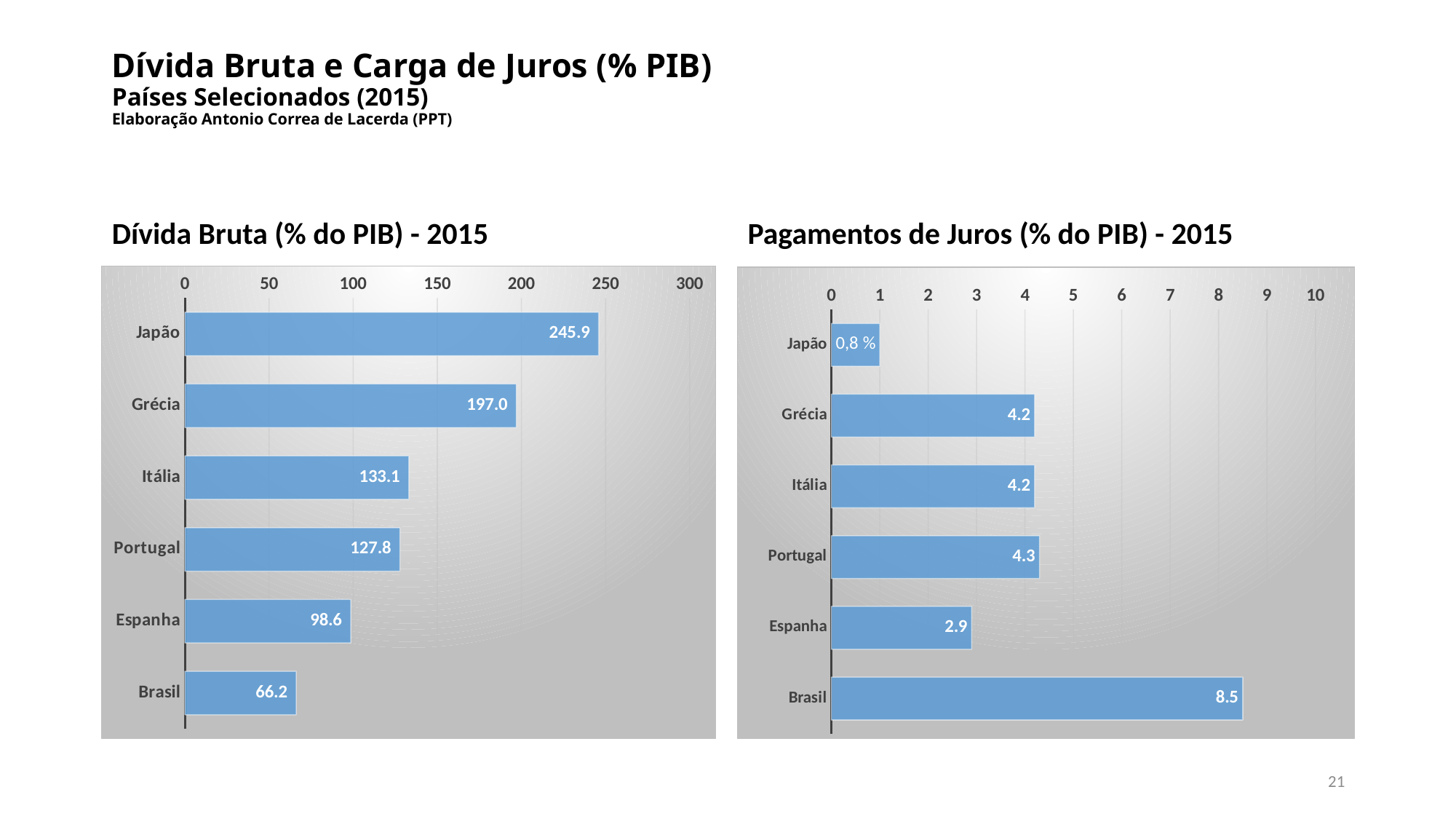
In the 'Dívida Bruta (% do PIB) - 2015' chart, what is the value for Japão? 245.9 What kind of chart is the 'Dívida Bruta (% do PIB) - 2015' chart? Bar chart In the 'Pagamentos de Juros (% do PIB) - 2015' chart, which country has the lowest value? Japão In the 'Dívida Bruta (% do PIB) - 2015' chart, how many countries are shown? 6 In the 'Dívida Bruta (% do PIB) - 2015' chart, what is the difference between the values for Grécia and Itália? 63.9 In the 'Pagamentos de Juros (% do PIB) - 2015' chart, what is the value for Espanha? 2.9 In the 'Pagamentos de Juros (% do PIB) - 2015' chart, what is the value for Brasil? 8.5 In the 'Dívida Bruta (% do PIB) - 2015' chart, what is the value for Brasil? 66.2 In the 'Pagamentos de Juros (% do PIB) - 2015' chart, which is larger, the value for Portugal or the value for Espanha? Portugal In the 'Dívida Bruta (% do PIB) - 2015' chart, which country has the lowest value? Brasil In the 'Pagamentos de Juros (% do PIB) - 2015' chart, which country has the highest value? Brasil In the 'Dívida Bruta (% do PIB) - 2015' chart, which country has the highest value? Japão